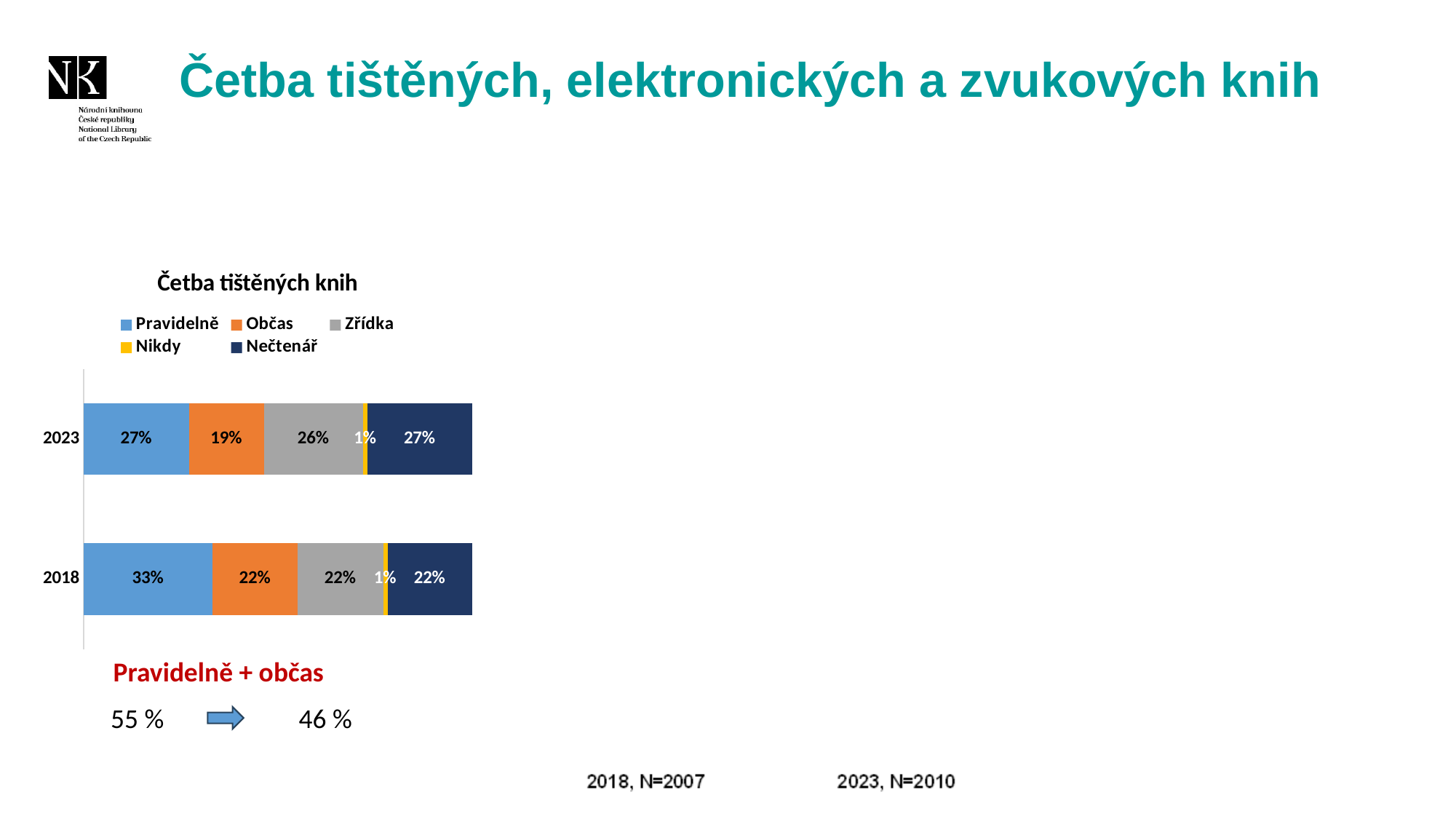
How many series does the legend list? 5 What kind of chart is shown? Stacked bar chart What is the value for Občas in 2018? 22% What is the title of the chart? Četba tištěných knih What is the difference between the Pravidelně values for 2018 and 2023? 6% What is the value for Pravidelně in 2023? 27% Which year has the higher value for Pravidelně, 2018 or 2023? 2018 What is the value for Nečtenář in 2018? 22% How many years (categories) are shown in the chart? 2 What is the value for Zřídka in 2023? 26% What is the difference between the Nečtenář values for 2023 and 2018? 5% What is the value for Nikdy in 2023? 1%